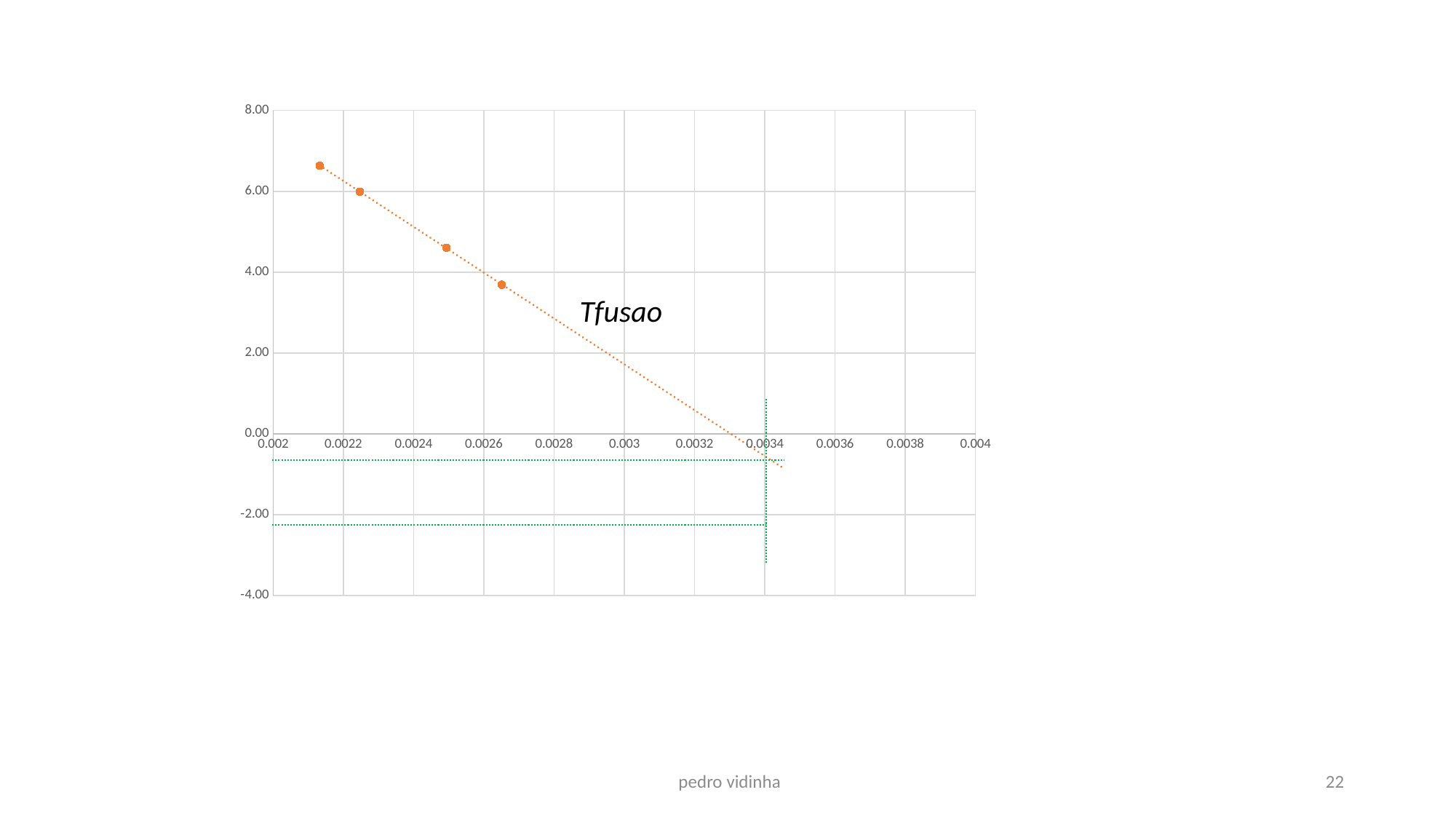
Is the value of the rightmost data point greater or less than 4.00? less What is the lowest value shown on the y axis? -4.00 Do the plotted values rise or fall as the x value increases? fall What text label is written next to the trendline on the chart? Tfusao What kind of chart is shown on the slide? scatter chart Is the value of the leftmost data point greater or less than 8.00? less Is the value of the leftmost data point greater or less than 6.00? greater Which data point has the highest y value, the leftmost or the rightmost? the leftmost How many data points are plotted on the chart? 4